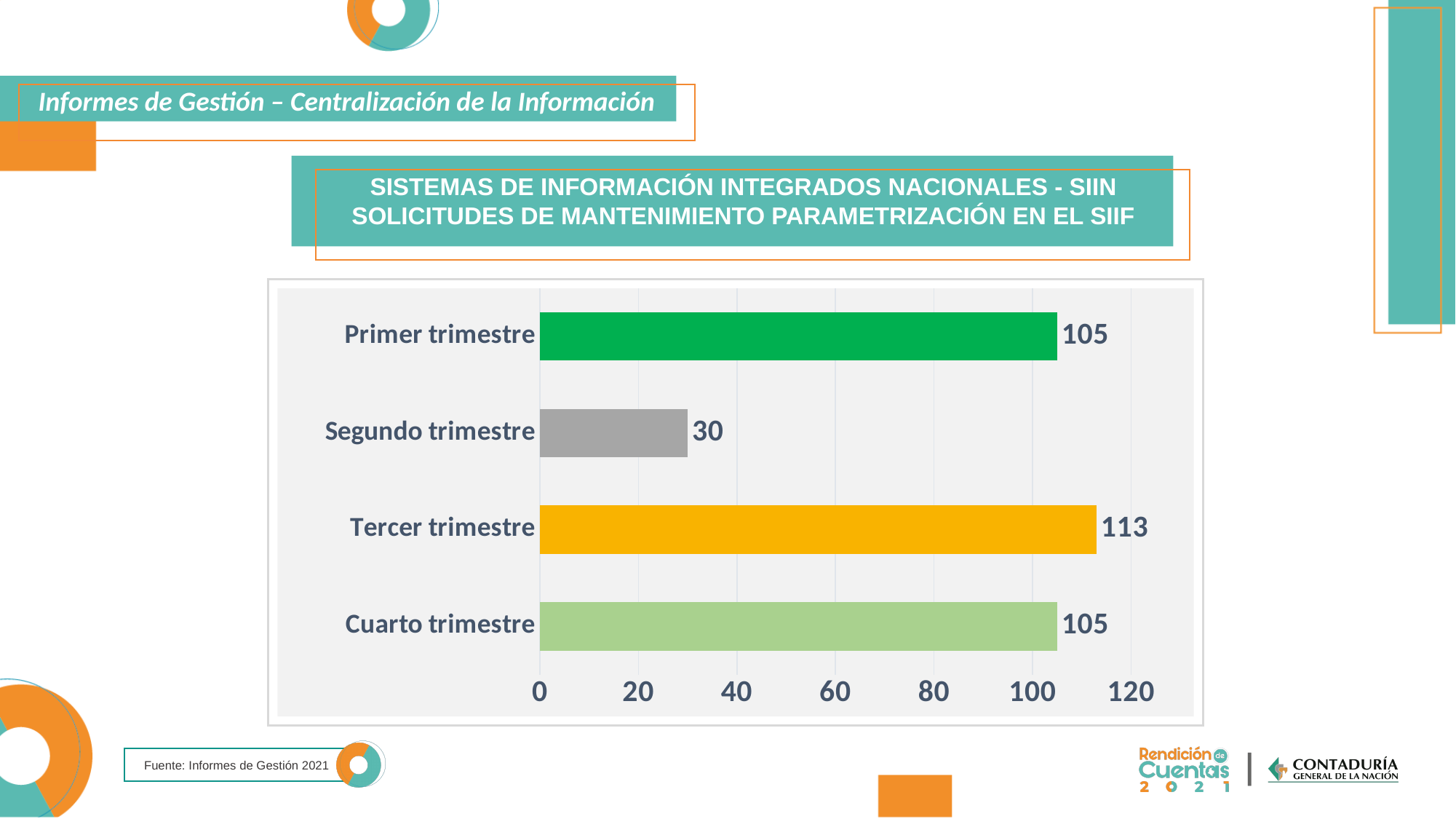
Which quarter has the lowest value? Segundo trimestre Is the value for Segundo trimestre greater or less than 40? less What is the total of the four quarterly values shown in the chart? 353 Which quarter has the highest value? Tercer trimestre What is the difference between the values for Tercer trimestre and Segundo trimestre? 83 What kind of chart is shown on the slide? bar chart Which is larger, the value for Tercer trimestre or the value for Primer trimestre? Tercer trimestre How many quarters are shown in the chart? 4 What is the value for Segundo trimestre? 30 What is the value for Cuarto trimestre? 105 What is the value for Tercer trimestre? 113 What is the value for Primer trimestre? 105